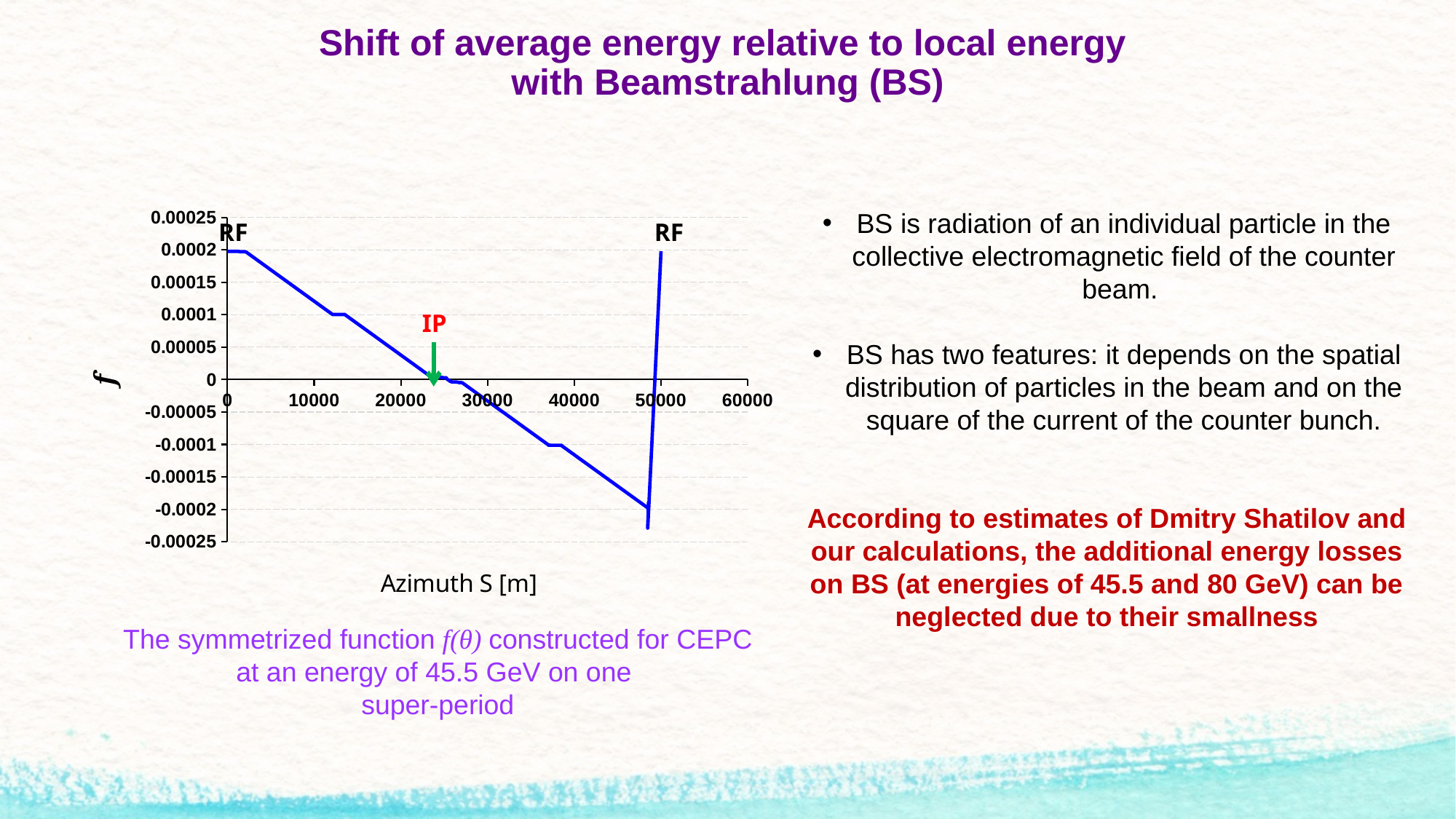
What kind of chart is shown on the slide? line chart Is the value of the line at Azimuth S = 10000 greater or less than 0.0001? greater What is the label of the x axis of the chart? Azimuth S [m] What is the highest tick value shown on the x axis? 60000 Does the plotted line rise or fall along the x axis between 0 and about 49000 m? fall What is the lowest tick value shown on the y axis? -0.00025 Is the value of the line at Azimuth S = 0 greater or less than 0.00015? greater Is the value of the line at Azimuth S = 40000 greater or less than -0.00005? less How many tick labels are shown on the x axis? 7